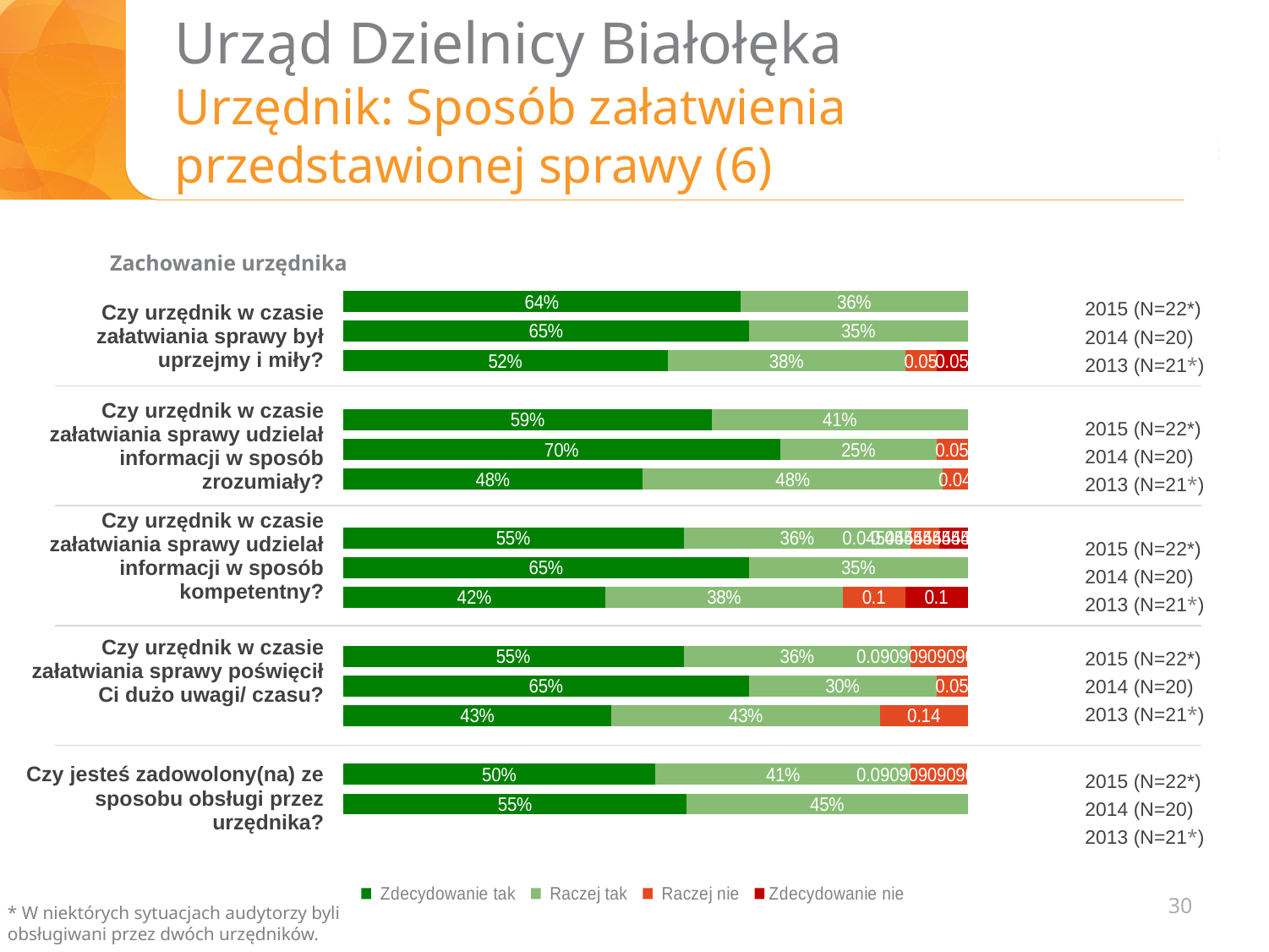
What is the subtitle shown above the chart? Zachowanie urzędnika What is the 'Zdecydowanie tak' value for 2015 (N=22*) for the question 'Czy urzędnik w czasie załatwiania sprawy był uprzejmy i miły?'? 64% What type of chart is shown on the slide? bar chart Which year has the lowest 'Zdecydowanie tak' value for the question 'Czy urzędnik w czasie załatwiania sprawy poświęcił Ci dużo uwagi/ czasu?'? 2013 (N=21*) What is the 'Raczej tak' value for 2014 (N=20) for the question 'Czy urzędnik w czasie załatwiania sprawy udzielał informacji w sposób zrozumiały?'? 25% For the question 'Czy jesteś zadowolony(na) ze sposobu obsługi przez urzędnika?', which year has the larger 'Zdecydowanie tak' value, 2015 (N=22*) or 2014 (N=20)? 2014 (N=20) How many series does the legend list? 4 What is the 'Raczej tak' value for 2014 (N=20) for the question 'Czy jesteś zadowolony(na) ze sposobu obsługi przez urzędnika?'? 45% Which year has the highest 'Zdecydowanie tak' value for the question 'Czy urzędnik w czasie załatwiania sprawy udzielał informacji w sposób zrozumiały?'? 2014 (N=20) How many survey questions are shown in the chart? 5 What is the difference between the 'Zdecydowanie tak' values for 2014 (N=20) and 2013 (N=21*) for the question 'Czy urzędnik w czasie załatwiania sprawy był uprzejmy i miły?'? 13% What is the 'Zdecydowanie tak' value for 2013 (N=21*) for the question 'Czy urzędnik w czasie załatwiania sprawy udzielał informacji w sposób kompetentny?'? 42%